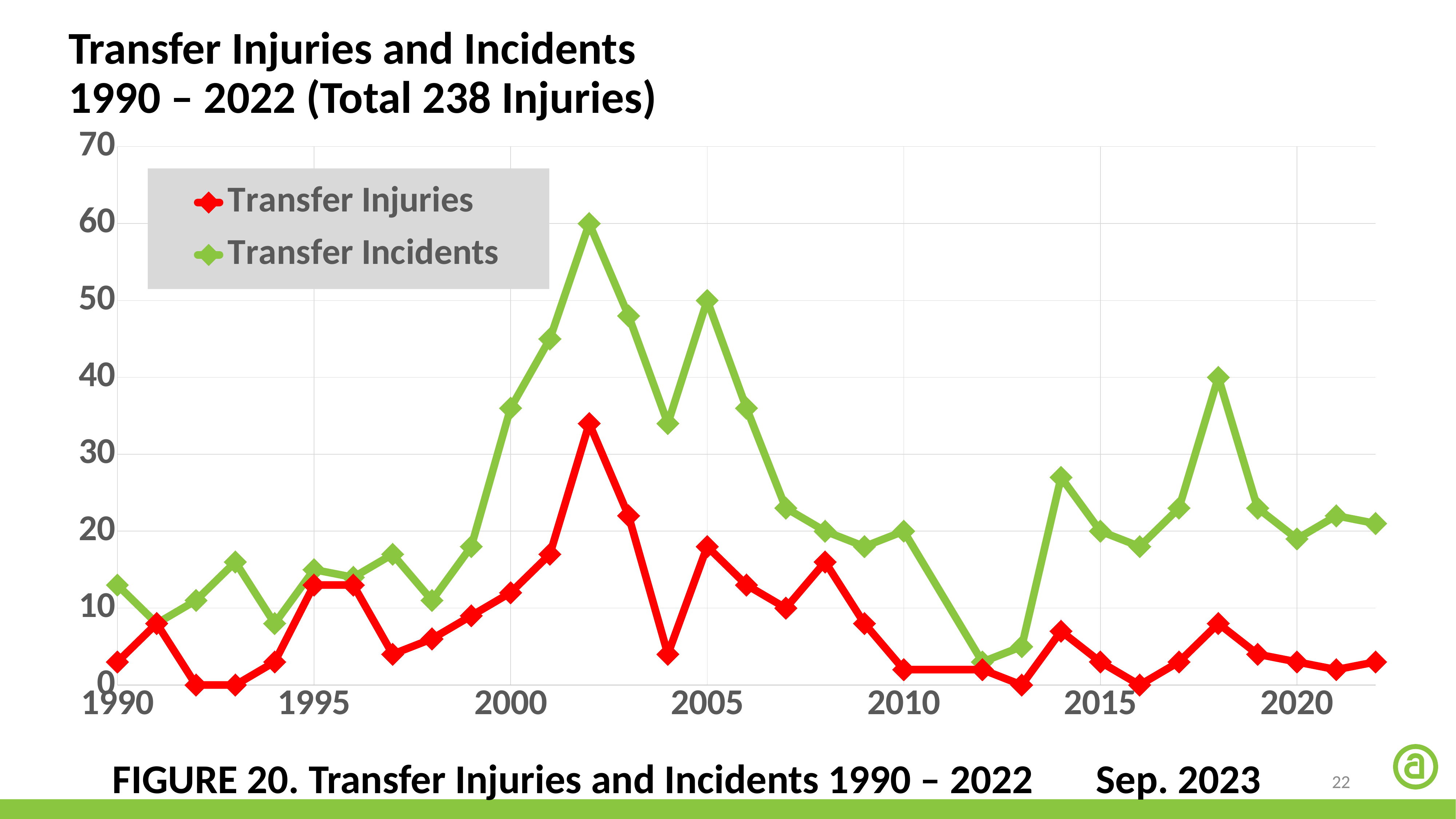
What is the title of the chart? Transfer Injuries and Incidents 1990 – 2022 (Total 238 Injuries) Is the value for Transfer Incidents in 2012 greater or less than 10? less What is the value of Transfer Incidents in 2002? 60 What kind of chart is shown on the slide? line chart What is the value of Transfer Incidents in 2005? 50 What is the value of Transfer Incidents in 2018? 40 Is the value for Transfer Injuries in 2002 greater or less than 30? greater In 2002, which series has the larger value, Transfer Injuries or Transfer Incidents? Transfer Incidents In which year does Transfer Incidents reach its highest value? 2002 Do the Transfer Incidents values rise or fall from 1999 to 2002? rise How many series does the legend list? 2 Which series is drawn in green? Transfer Incidents